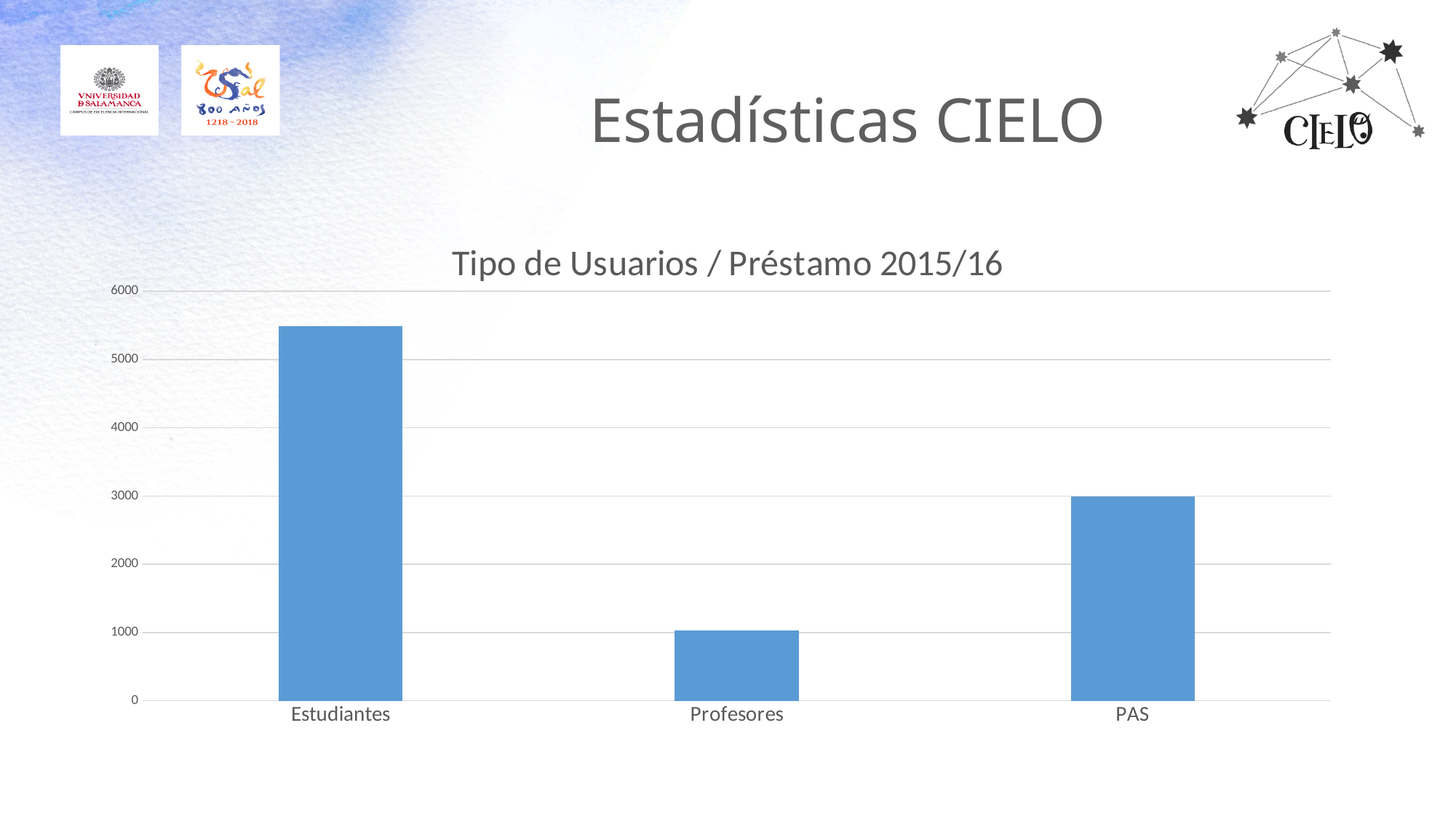
How many categories are shown on the x axis of the chart? 3 Which is larger, the value for PAS or the value for Profesores? PAS Which is larger, the value for Estudiantes or the value for PAS? Estudiantes Is the value for PAS greater or less than 2000? greater Is the value for Estudiantes greater or less than 6000? less What type of chart is shown on the slide? bar chart Which category has the lowest value? Profesores Which category has the highest value? Estudiantes Is the value for Estudiantes greater or less than 5000? greater What is the title of the chart? Tipo de Usuarios / Préstamo 2015/16